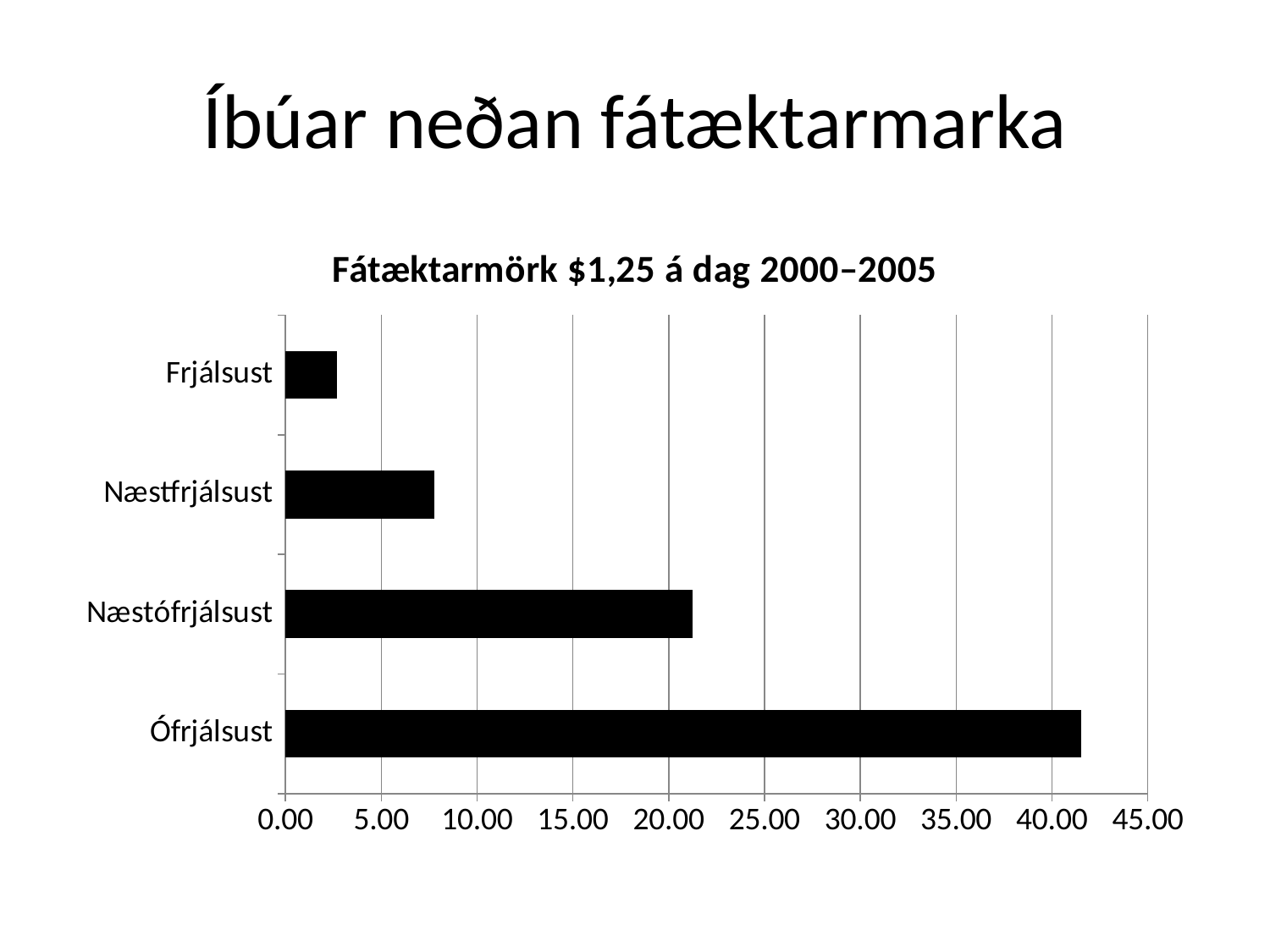
Which category has the lowest value? Frjálsust Which has a larger value, Frjálsust or Ófrjálsust? Ófrjálsust How many categories are plotted in the chart? 4 What kind of chart is shown on the slide? bar chart What is the highest value shown on the horizontal axis? 45.00 Is the value for Ófrjálsust greater or less than 40.00? greater Which has a larger value, Næstfrjálsust or Næstófrjálsust? Næstófrjálsust Is the value for Frjálsust greater or less than 5.00? less Is the value for Næstófrjálsust greater or less than 20.00? greater What is the title of the chart? Fátæktarmörk $1,25 á dag 2000–2005 Which category has the highest value? Ófrjálsust